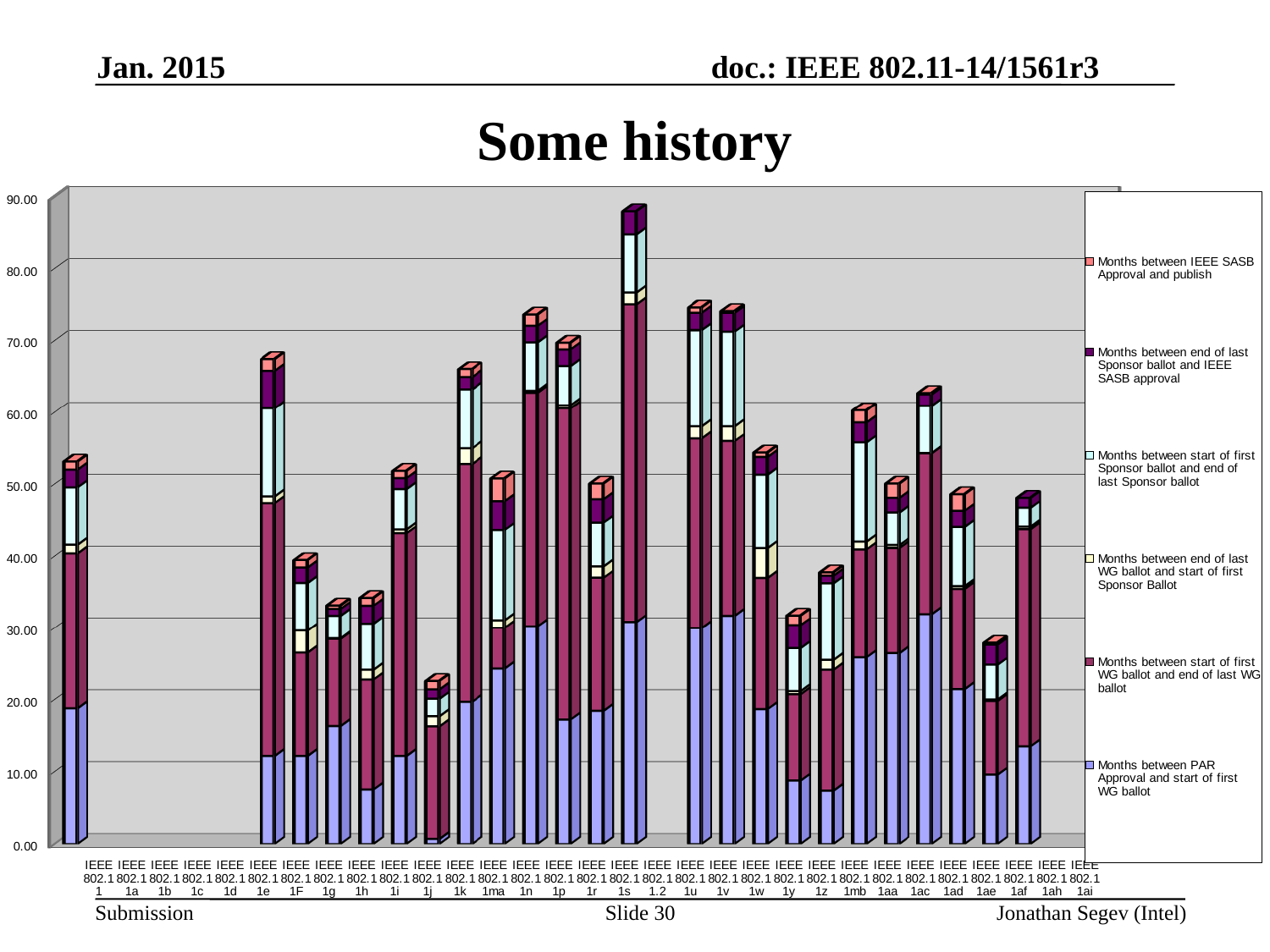
How many series does the legend list? 6 What is the title of the chart? Some history Which has the larger total, IEEE 802.11e or IEEE 802.11F? IEEE 802.11e Is the total for IEEE 802.11g greater or less than 40? less Which category has the tallest stacked bar? IEEE 802.11s Is the total for IEEE 802.11s greater or less than 80? greater Is the total for IEEE 802.11e greater or less than 60? greater Which has the larger total, IEEE 802.11s or IEEE 802.11n? IEEE 802.11s Which series is listed last (at the bottom) in the legend? Months between PAR Approval and start of first WG ballot What kind of chart is shown on the slide? stacked bar chart Which has the larger total, IEEE 802.11u or IEEE 802.11y? IEEE 802.11u